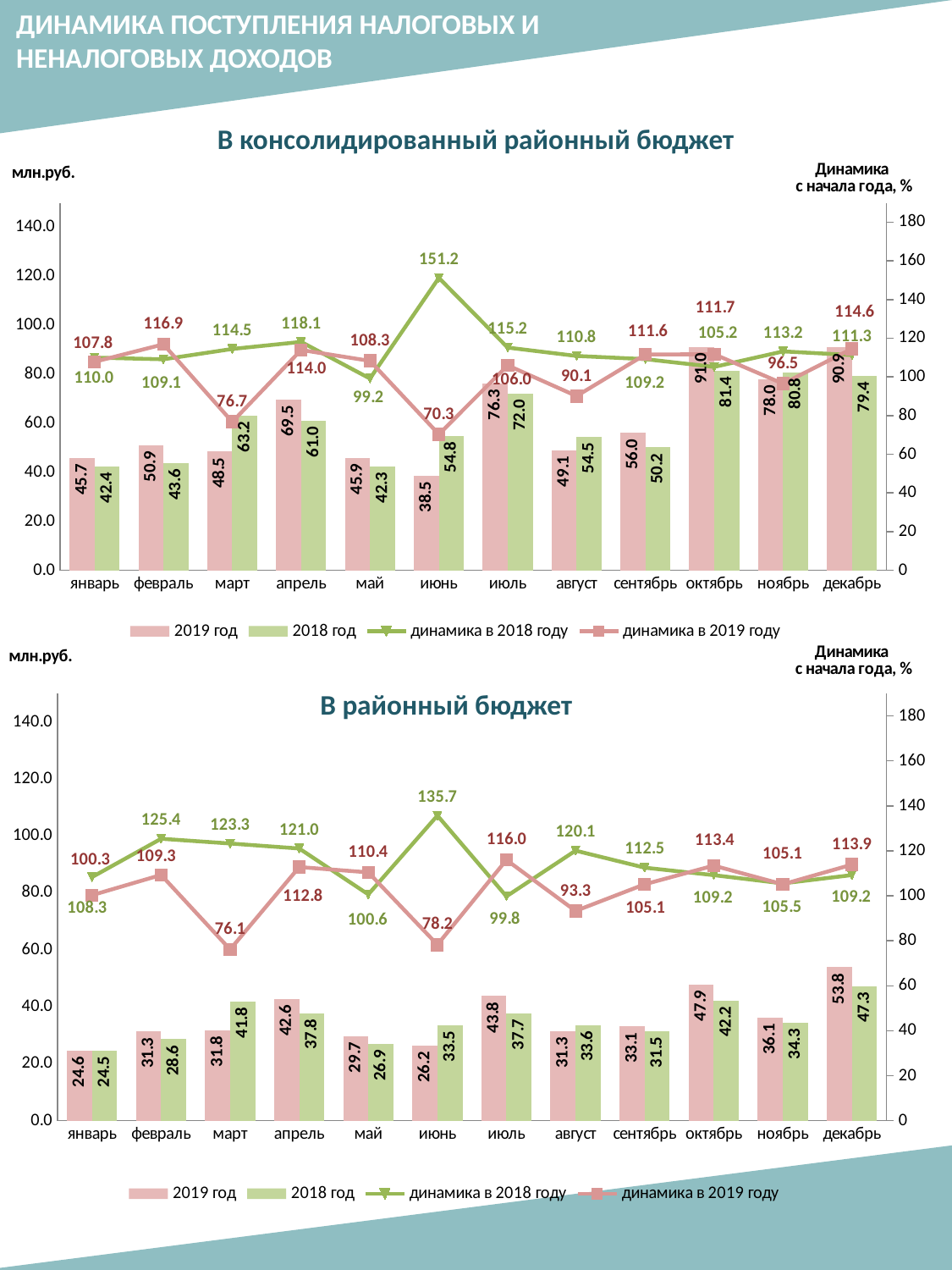
How many months are shown on the x axis of the chart 'В консолидированный районный бюджет'? 12 In the chart 'В консолидированный районный бюджет', which series has the larger value for март: '2019 год' or '2018 год'? 2018 год In the chart 'В районный бюджет', which month has the highest '2019 год' bar? декабрь In the chart 'В консолидированный районный бюджет', what is the value of '2019 год' for октябрь? 91.0 In the chart 'В консолидированный районный бюджет', which month has the lowest '2019 год' bar? июнь What kind of chart is 'В районный бюджет'? Combined bar and line chart In the chart 'В районный бюджет', what is the value of '2018 год' for декабрь? 47.3 In the chart 'В районный бюджет', in which month does the 'динамика в 2019 году' line reach its lowest value? март In the chart 'В консолидированный районный бюджет', in which month does the 'динамика в 2018 году' line reach its highest value? июнь In the chart 'В районный бюджет', what is the difference between the '2018 год' and '2019 год' values for июнь? 7.3 In the chart 'В консолидированный районный бюджет', what is the difference between the '2019 год' and '2018 год' values for апрель? 8.5 How many series does the legend of the chart 'В районный бюджет' list? 4